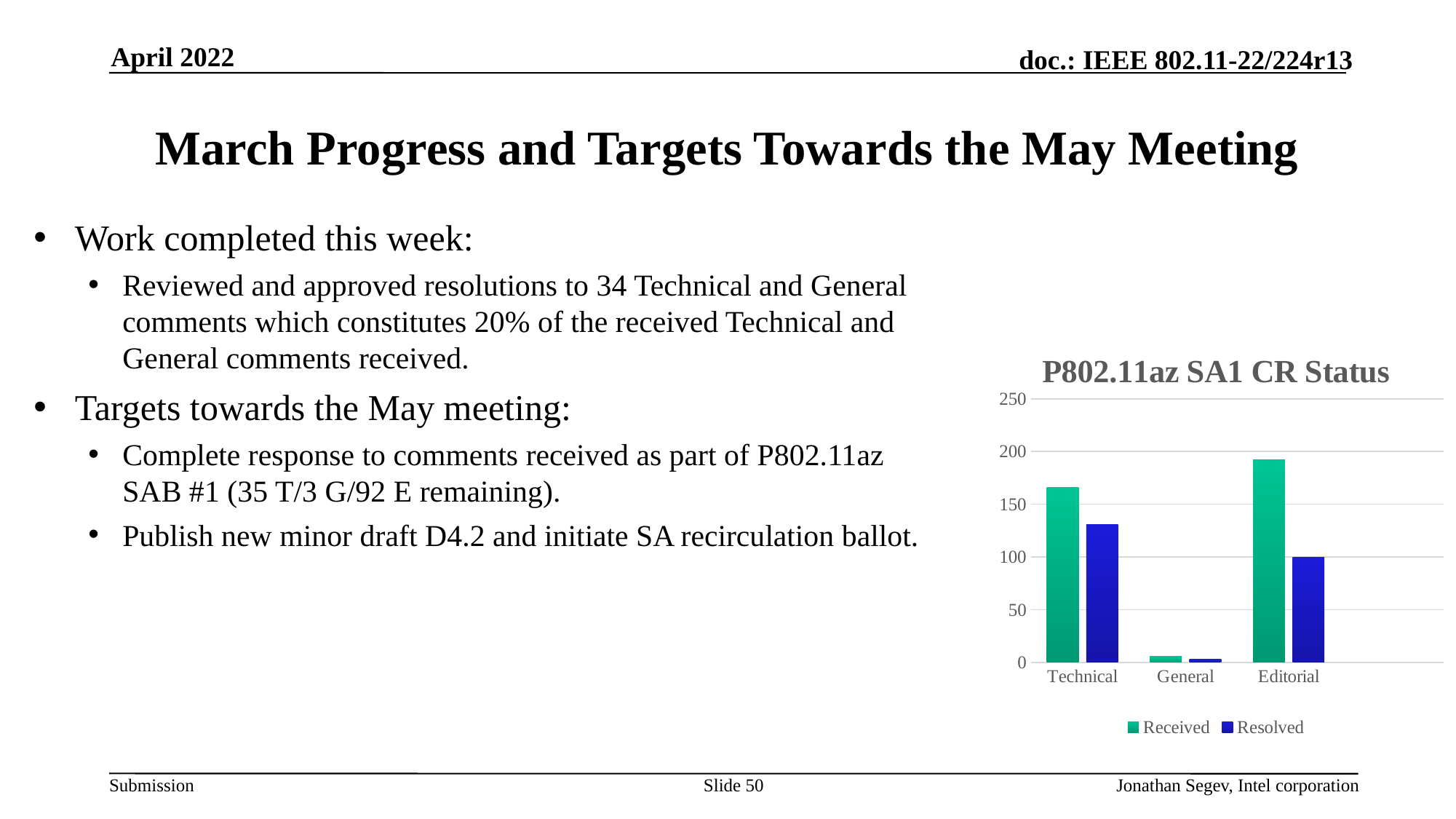
Is the Resolved value for Editorial greater or less than 150? less What kind of chart is the P802.11az SA1 CR Status chart? bar chart Which category has the highest Received value in the P802.11az SA1 CR Status chart? Editorial How many categories are shown on the x axis of the P802.11az SA1 CR Status chart? 3 Is the Received value for General greater or less than 50? less How many series does the legend of the P802.11az SA1 CR Status chart list? 2 Which is larger, the Received value for Technical or the Received value for Editorial? Editorial What is the title of the chart on the slide? P802.11az SA1 CR Status Which is larger, the Resolved value for Technical or the Resolved value for Editorial? Technical Is the Resolved value for Technical greater or less than 150? less Which category has the lowest Resolved value in the P802.11az SA1 CR Status chart? General